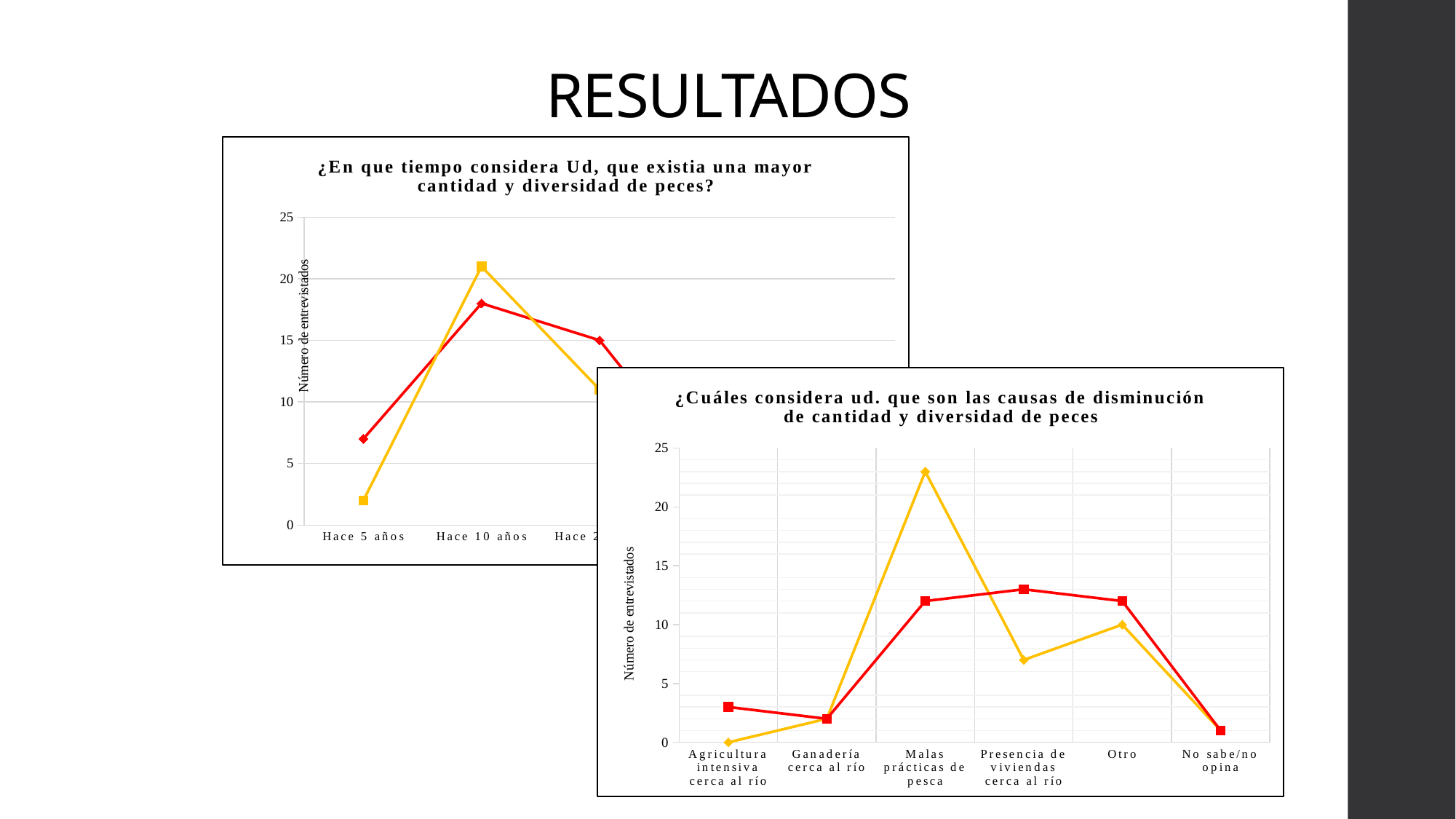
In the chart titled '¿Cuáles considera ud. que son las causas de disminución de cantidad y diversidad de peces', which line is higher at Presencia de viviendas cerca al río, the yellow line or the red line? The red line In the chart titled '¿En que tiempo considera Ud, que existia una mayor cantidad y diversidad de peces?', is the red line's value for Hace 10 años greater or less than 15? greater In the chart titled '¿En que tiempo considera Ud, que existia una mayor cantidad y diversidad de peces?', is the yellow line's value for Hace 5 años greater or less than 5? less In the chart titled '¿Cuáles considera ud. que son las causas de disminución de cantidad y diversidad de peces', is the red line's value for Presencia de viviendas cerca al río greater or less than 10? greater In the chart titled '¿Cuáles considera ud. que son las causas de disminución de cantidad y diversidad de peces', how many categories are shown on the x axis? 6 What kind of chart is the chart titled '¿Cuáles considera ud. que son las causas de disminución de cantidad y diversidad de peces'? Line chart In the chart titled '¿En que tiempo considera Ud, que existia una mayor cantidad y diversidad de peces?', at which visible category does the yellow line reach its highest value? Hace 10 años In the chart titled '¿Cuáles considera ud. que son las causas de disminución de cantidad y diversidad de peces', at which category does the yellow line have its lowest value? Agricultura intensiva cerca al río In the chart titled '¿Cuáles considera ud. que son las causas de disminución de cantidad y diversidad de peces', at which category does the yellow line reach its highest value? Malas prácticas de pesca What is the y-axis label of the chart titled '¿Cuáles considera ud. que son las causas de disminución de cantidad y diversidad de peces'? Número de entrevistados In the chart titled '¿Cuáles considera ud. que son las causas de disminución de cantidad y diversidad de peces', which line is higher at Malas prácticas de pesca, the yellow line or the red line? The yellow line